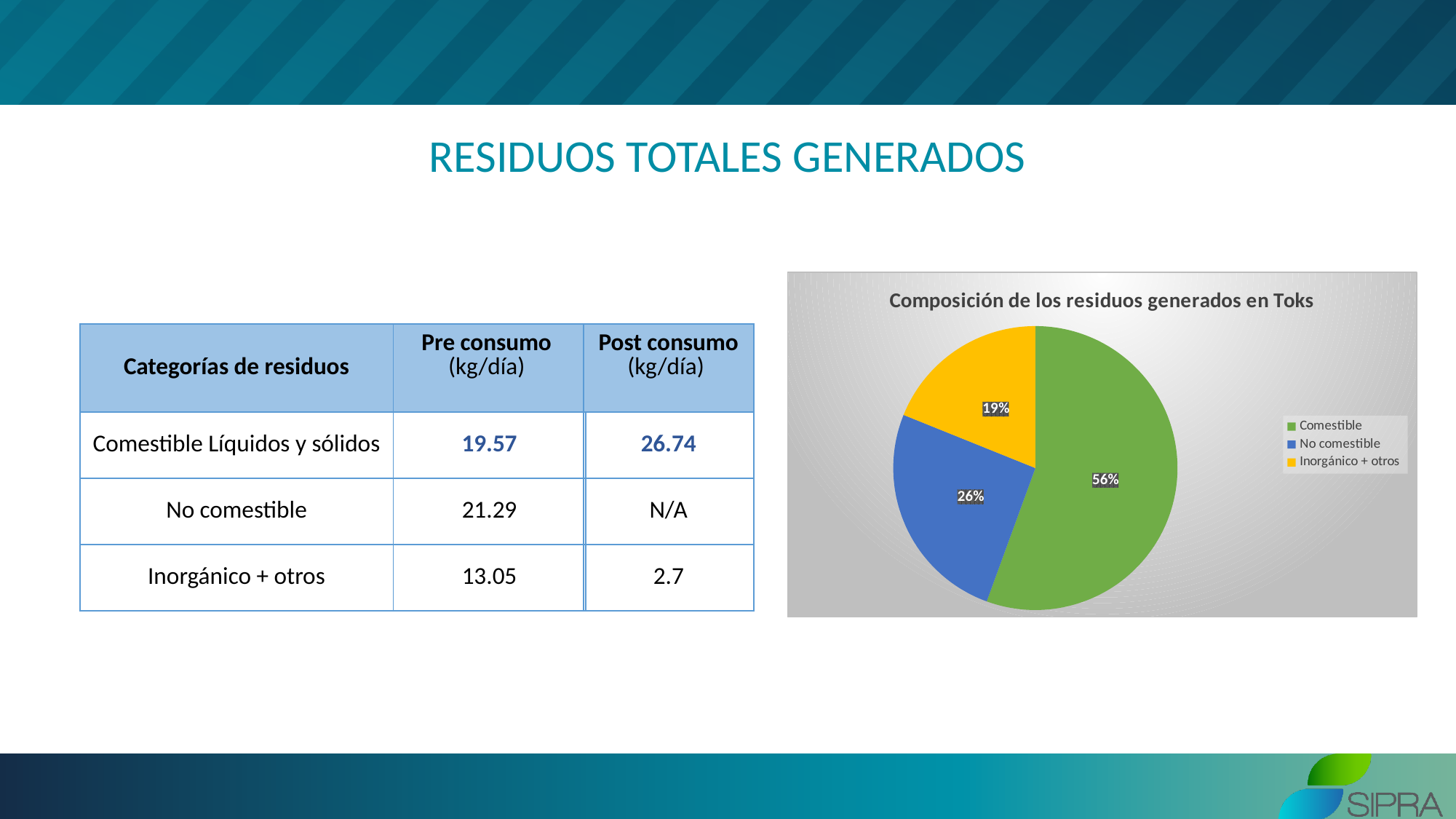
Which slice is larger, No comestible or Inorgánico + otros? No comestible Which category has the largest slice of the pie? Comestible What share of the pie does Comestible represent? 56% What is the title of the pie chart? Composición de los residuos generados en Toks How many slices does the pie chart have? 3 How many entries does the legend of the pie chart list? 3 What colour is the Comestible slice in the pie chart? green What is the difference in percentage points between the Comestible slice and the No comestible slice? 30 Which category has the smallest slice of the pie? Inorgánico + otros What share of the pie does Inorgánico + otros represent? 19% What share of the pie does No comestible represent? 26% What kind of chart is shown on the slide? pie chart